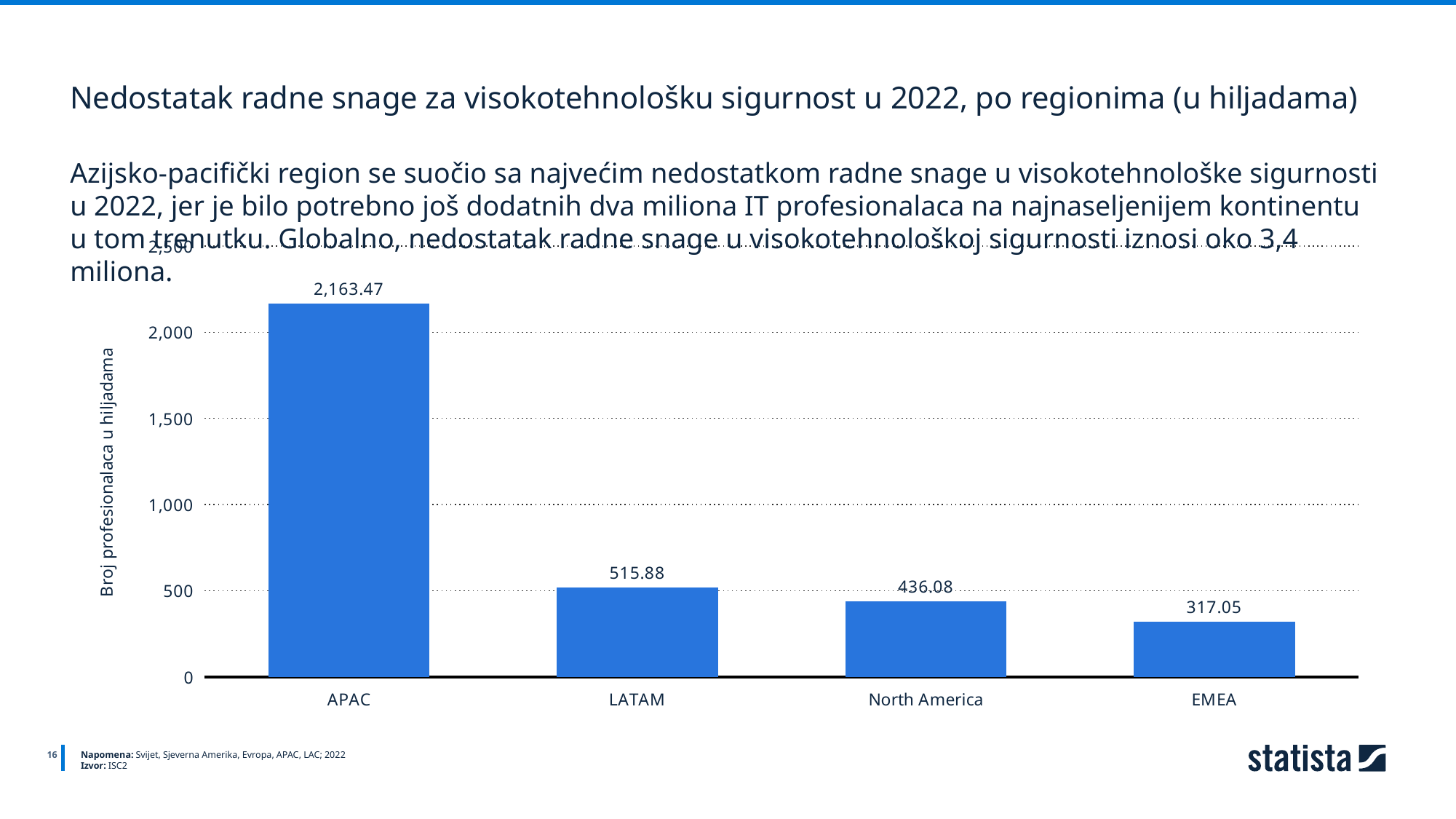
What is the difference between the values for North America and EMEA? 119.03 Which region has the lowest value? EMEA How many regions are shown in the chart? 4 Is the value for APAC greater or less than 2,000? greater What is the value for EMEA? 317.05 What is the value for North America? 436.08 What is the difference between the values for APAC and LATAM? 1,647.59 What is the value for LATAM? 515.88 Which region has the highest value? APAC Which is larger, the value for LATAM or the value for North America? LATAM What is the value for APAC? 2,163.47 What kind of chart is shown on the slide? Bar chart